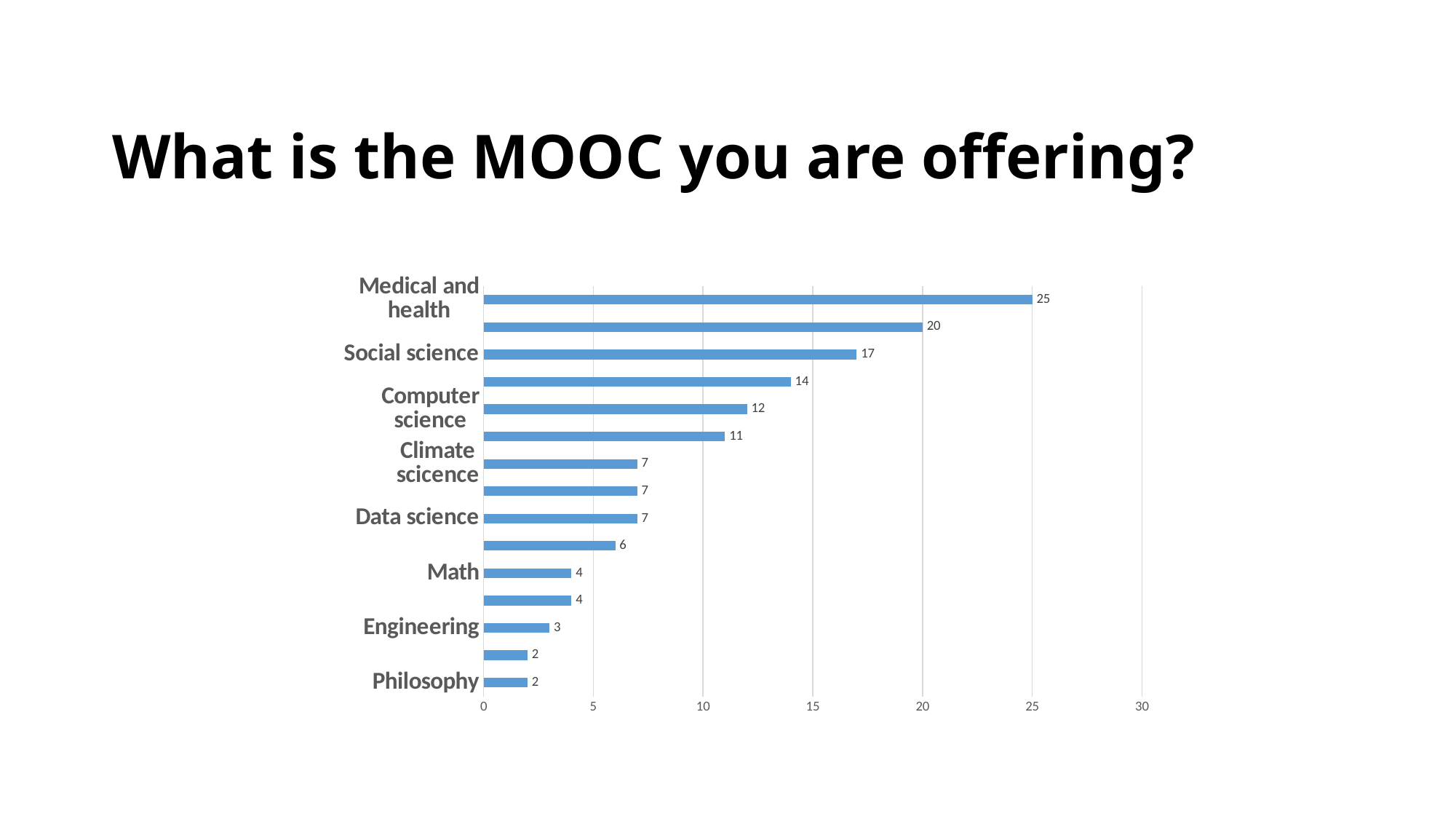
What is the value for Engineering? 3 What is the difference between the values for Medical and health and Social science? 8 What is the difference between the values for Computer science and Math? 8 Which is larger, the value for Data science or the value for Math? Data science What is the value for Computer science? 12 Which category has the highest value? Medical and health What is the value for Social science? 17 What type of chart is shown on the slide? bar chart What is the value for Philosophy? 2 What is the value for Medical and health? 25 How many bars are plotted in the chart? 15 What is the title of the slide? What is the MOOC you are offering?